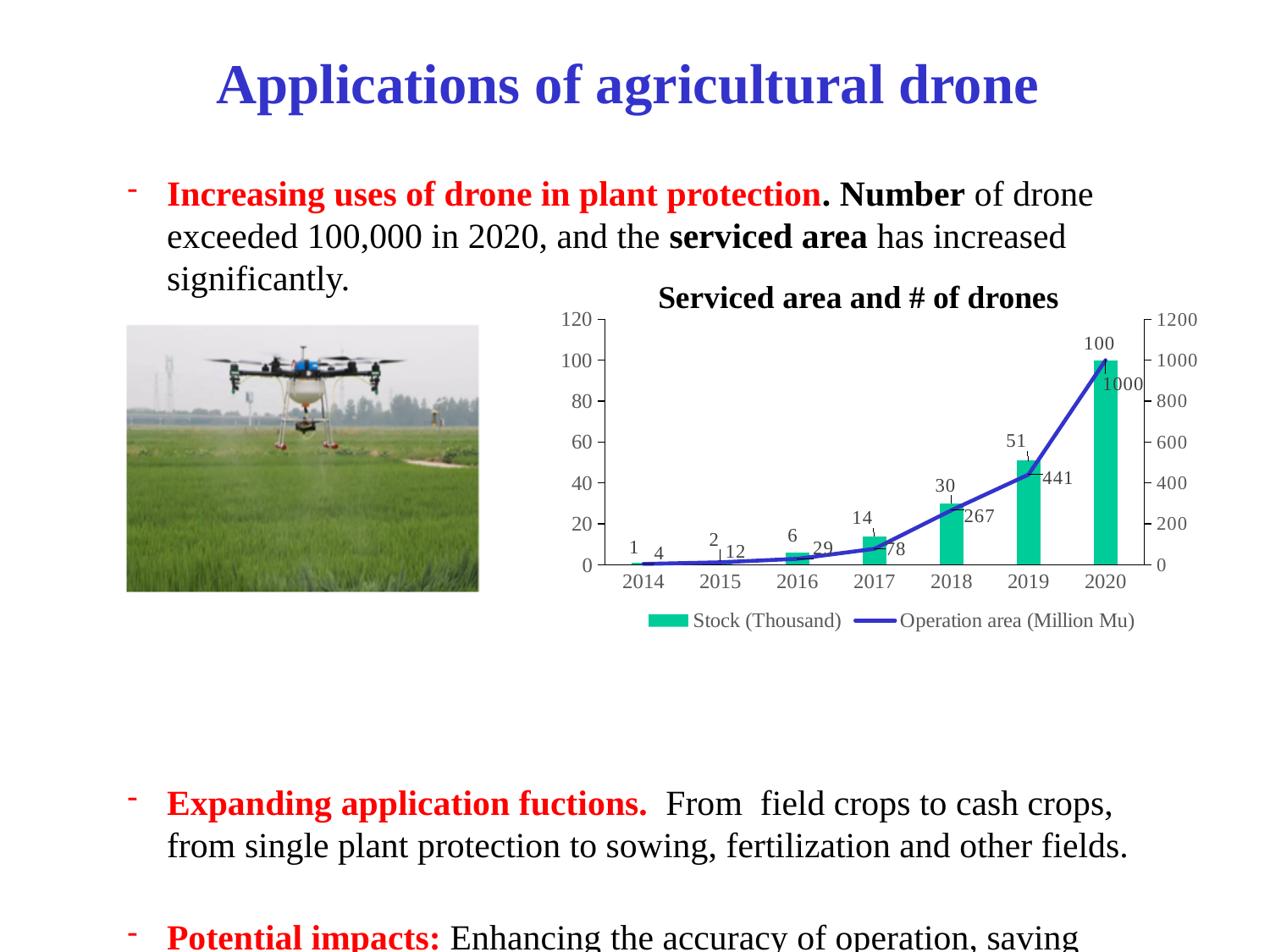
Which year has the lowest Operation area (Million Mu) value? 2014 What is the Operation area (Million Mu) value for 2016? 29 How many years are shown on the x axis of the chart? 7 What is the Operation area (Million Mu) value for 2019? 441 Which year has the highest Stock (Thousand) value? 2020 What is the difference in Operation area (Million Mu) between 2018 and 2017? 189 Does the Operation area (Million Mu) rise or fall from 2014 to 2020? rise What is the Stock (Thousand) value for 2018? 30 Which year has a larger Stock (Thousand) value, 2017 or 2019? 2019 What is the difference in Stock (Thousand) between 2020 and 2019? 49 What is the title of the chart? Serviced area and # of drones How many series does the chart legend list? 2